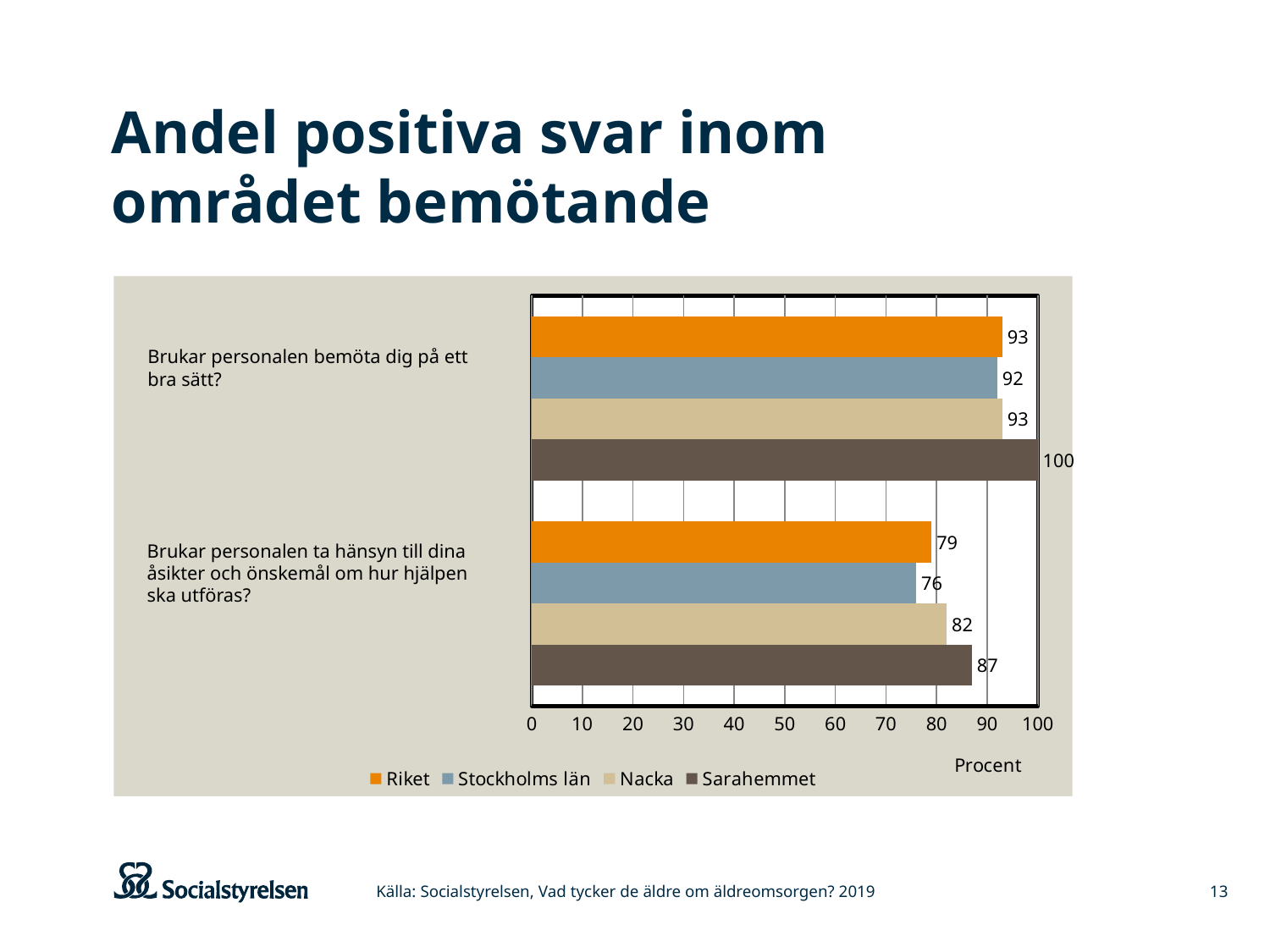
What is the difference between the Sarahemmet value and the Stockholms län value for the question "Brukar personalen bemöta dig på ett bra sätt?"? 8 Which series has the lowest value for the question "Brukar personalen ta hänsyn till dina åsikter och önskemål om hur hjälpen ska utföras?"? Stockholms län What value is shown for Riket for the question "Brukar personalen bemöta dig på ett bra sätt?"? 93 How many series does the legend list? 4 What is the label of the x axis? Procent What value is shown for Stockholms län for the question "Brukar personalen ta hänsyn till dina åsikter och önskemål om hur hjälpen ska utföras?"? 76 What is the difference between the Sarahemmet value and the Riket value for the question "Brukar personalen ta hänsyn till dina åsikter och önskemål om hur hjälpen ska utföras?"? 8 What value is shown for Sarahemmet for the question "Brukar personalen bemöta dig på ett bra sätt?"? 100 What value is shown for Nacka for the question "Brukar personalen ta hänsyn till dina åsikter och önskemål om hur hjälpen ska utföras?"? 82 For the question "Brukar personalen ta hänsyn till dina åsikter och önskemål om hur hjälpen ska utföras?", which is larger: the value for Nacka or the value for Riket? Nacka Which series has the highest value for the question "Brukar personalen ta hänsyn till dina åsikter och önskemål om hur hjälpen ska utföras?"? Sarahemmet What kind of chart is shown on the slide? Bar chart